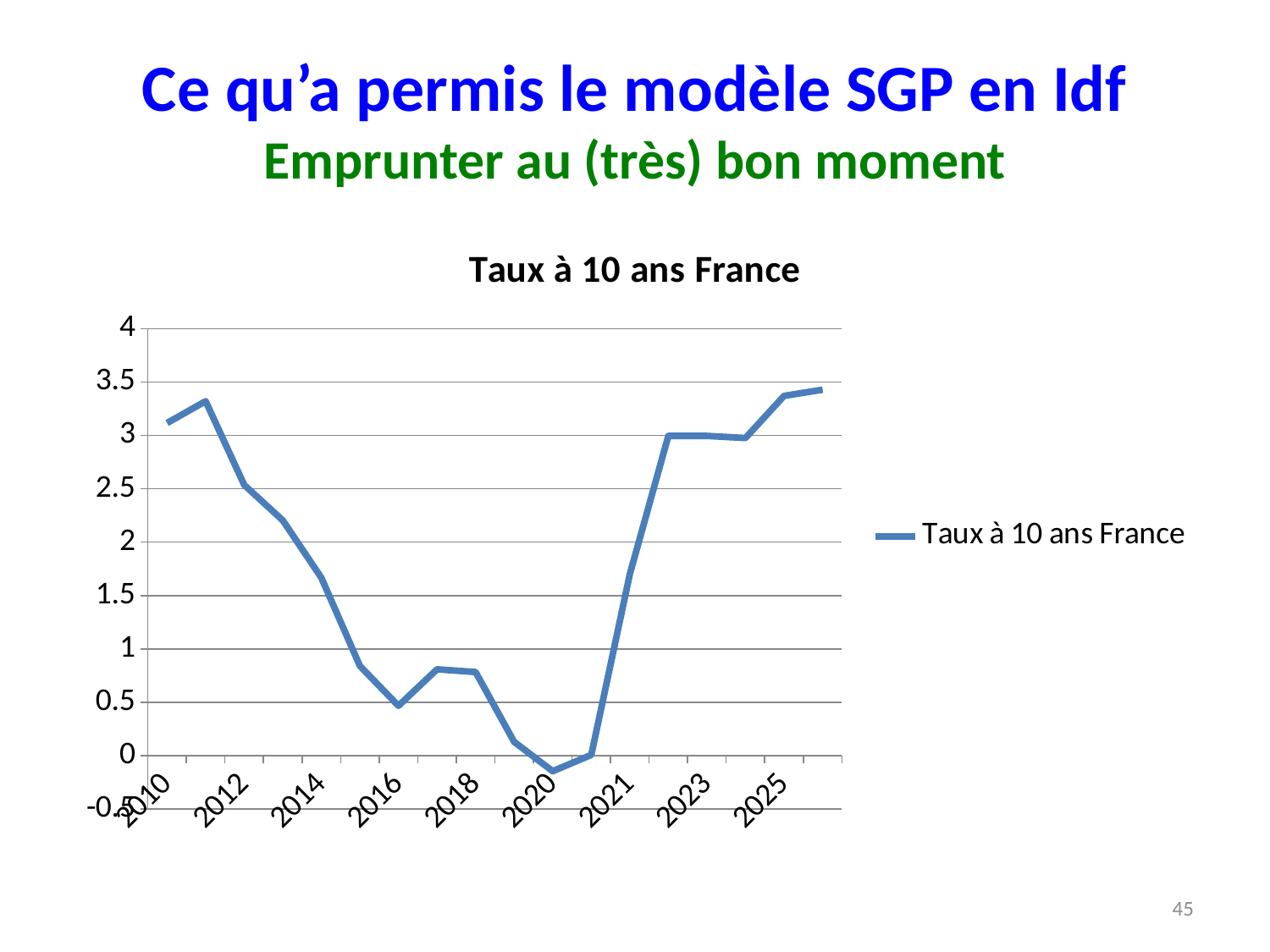
Is the value for 2025 greater or less than 3? greater What is the title of the chart? Taux à 10 ans France How many series does the legend list? 1 Is the value for 2016 greater or less than 1? less Is the value for 2012 greater or less than 2? greater Which year has the lowest value on the chart? 2020 What kind of chart is shown on the slide? line chart Does the value rise or fall between 2010 and 2016? fall What is the name of the series shown in the legend? Taux à 10 ans France